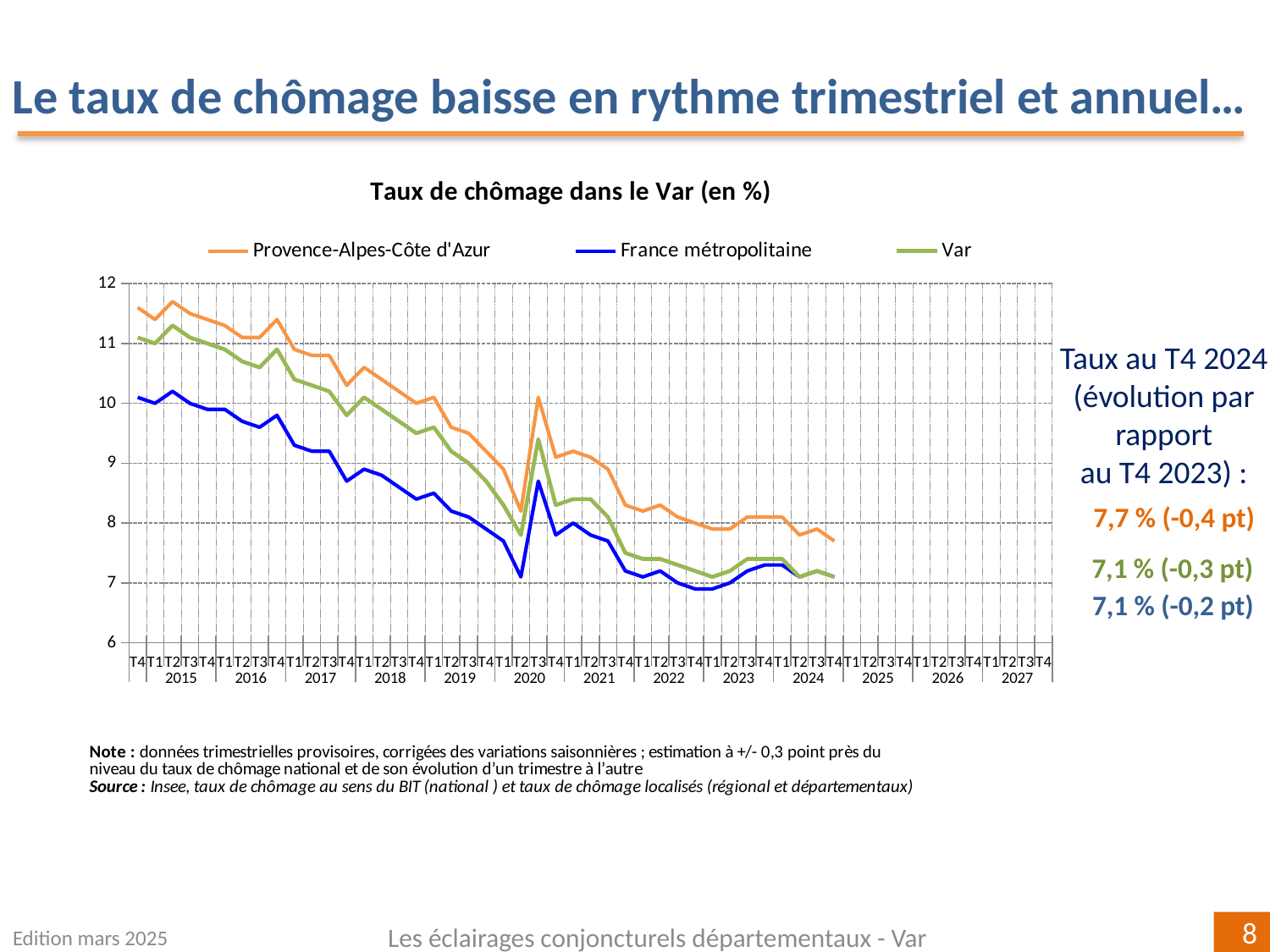
How many series does the legend list? 3 Which series has the highest values across the whole period shown? Provence-Alpes-Côte d'Azur What is the difference between the Provence-Alpes-Côte d'Azur rate and the Var rate at T4 2024? 0,6 pt Overall, do the unemployment rates rise or fall from 2015 to 2024? fall According to the text beside the chart, what is the unemployment rate for Provence-Alpes-Côte d'Azur at T4 2024? 7,7 % Is the value for France métropolitaine at T1 2020 greater or less than 8? less By how many points did the Provence-Alpes-Côte d'Azur rate change between T4 2023 and T4 2024, as stated on the slide? -0,4 pt What is the title of the chart? Taux de chômage dans le Var (en %) What kind of chart is shown on the slide? line chart Is the value for Provence-Alpes-Côte d'Azur at T4 2014 greater or less than 11? greater Which series is drawn in blue? France métropolitaine According to the text beside the chart, what is the unemployment rate for Var at T4 2024? 7,1 %